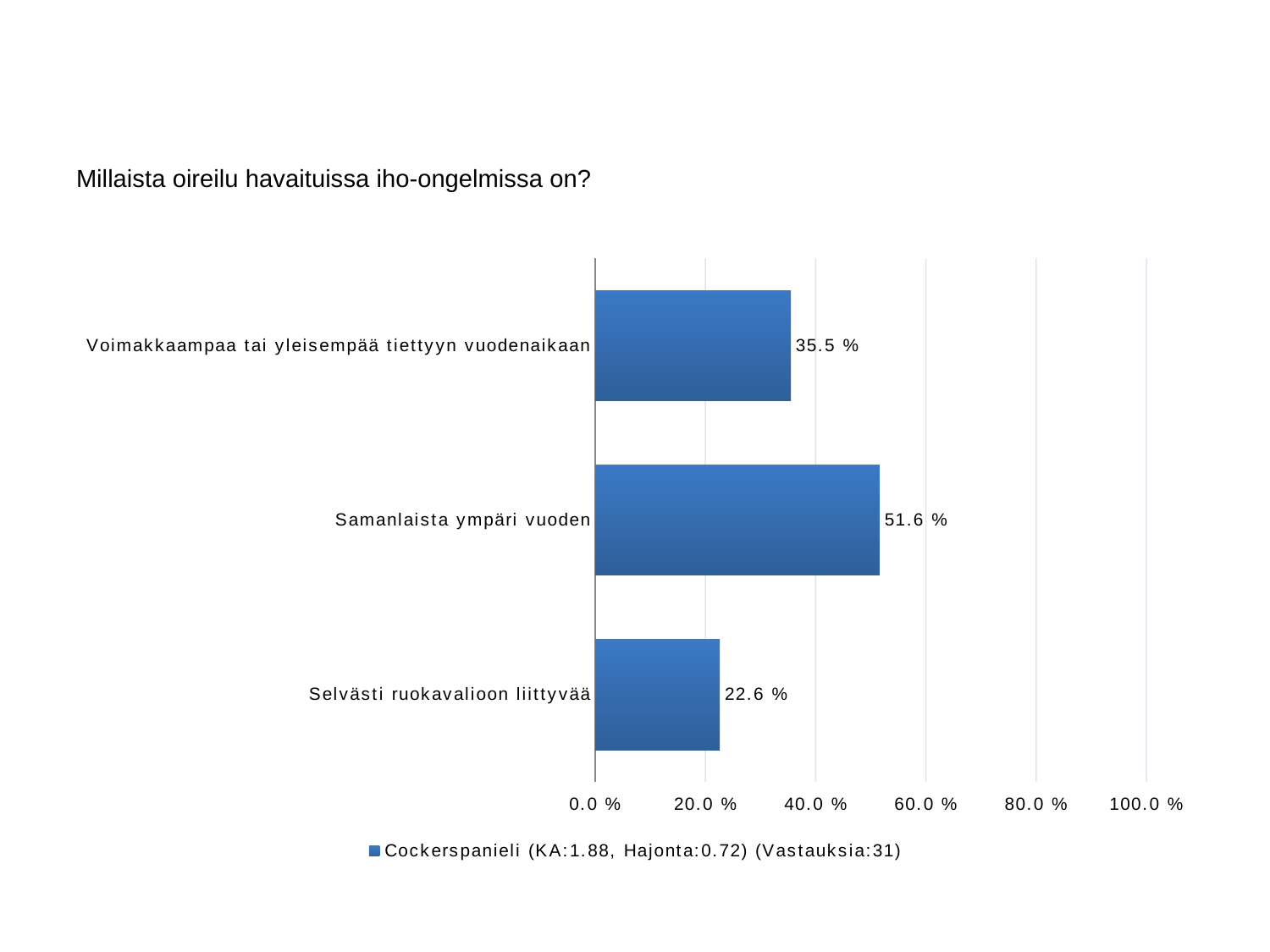
Which category has the lowest value? Selvästi ruokavalioon liittyvää Which is larger: the value for "Voimakkaampaa tai yleisempää tiettyyn vuodenaikaan" or for "Selvästi ruokavalioon liittyvää"? Voimakkaampaa tai yleisempää tiettyyn vuodenaikaan What is the difference between the values for "Samanlaista ympäri vuoden" and "Selvästi ruokavalioon liittyvää"? 29.0 % Is the value for "Samanlaista ympäri vuoden" greater or less than 40.0 %? greater How many categories are shown in the chart? 3 What is the value for "Selvästi ruokavalioon liittyvää"? 22.6 % What is the legend entry for the series shown in the chart? Cockerspanieli (KA:1.88, Hajonta:0.72) (Vastauksia:31) What kind of chart is shown on the slide? Bar chart What is the value for "Voimakkaampaa tai yleisempää tiettyyn vuodenaikaan"? 35.5 % What is the difference between the values for "Samanlaista ympäri vuoden" and "Voimakkaampaa tai yleisempää tiettyyn vuodenaikaan"? 16.1 % Which category has the highest value? Samanlaista ympäri vuoden What is the value for "Samanlaista ympäri vuoden"? 51.6 %